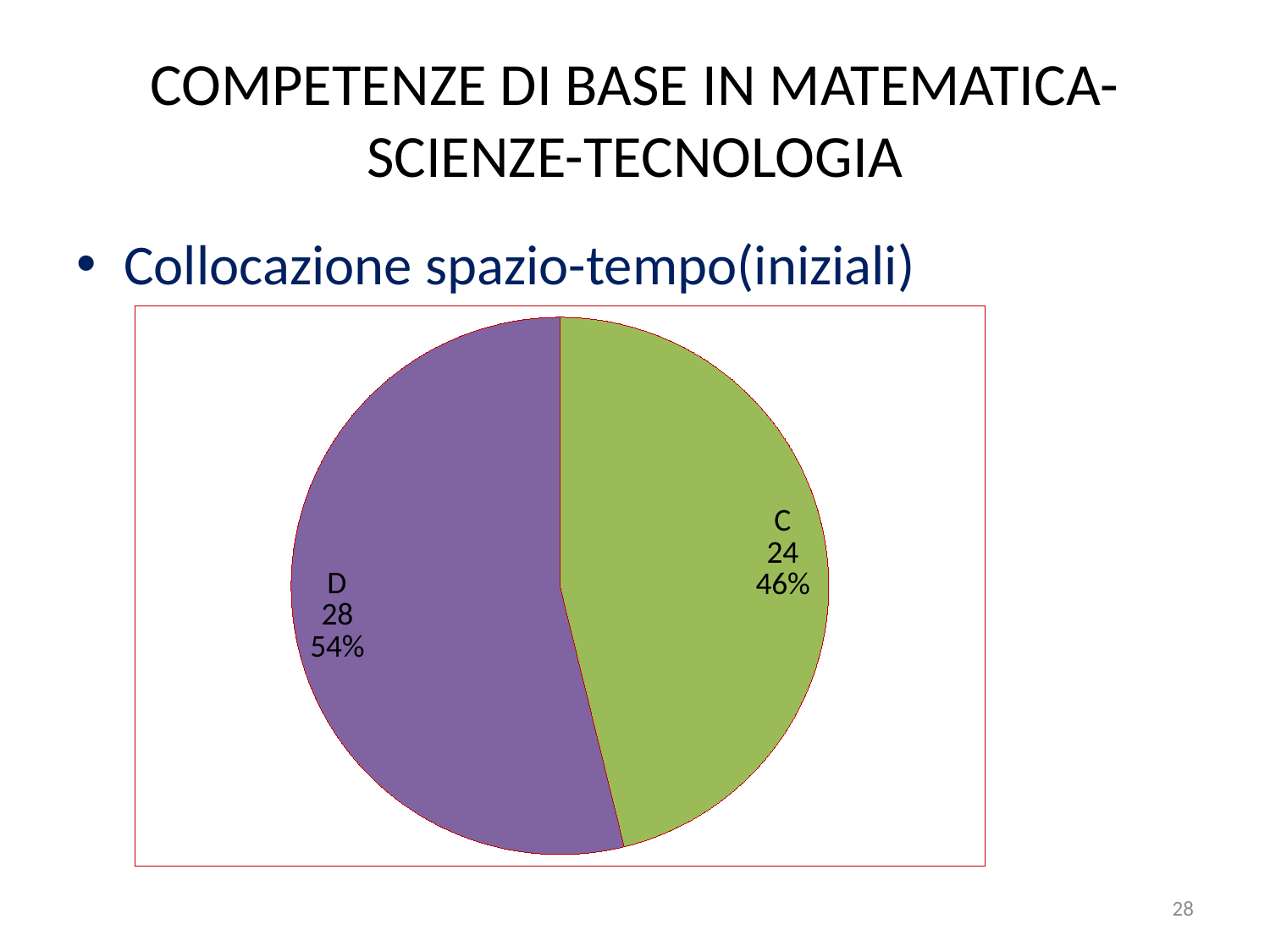
What share of the pie does slice C represent? 46% Which slice is the smallest? C What is the value for slice D? 28 What kind of chart is shown on the slide? pie chart How many slices does the pie chart have? 2 Which slice is the largest? D What colour is slice D? purple Which is larger, the value for C or the value for D? D What is the difference between the values of D and C? 4 What share of the pie does slice D represent? 54% What is the total of the two slice values? 52 What is the value for slice C? 24